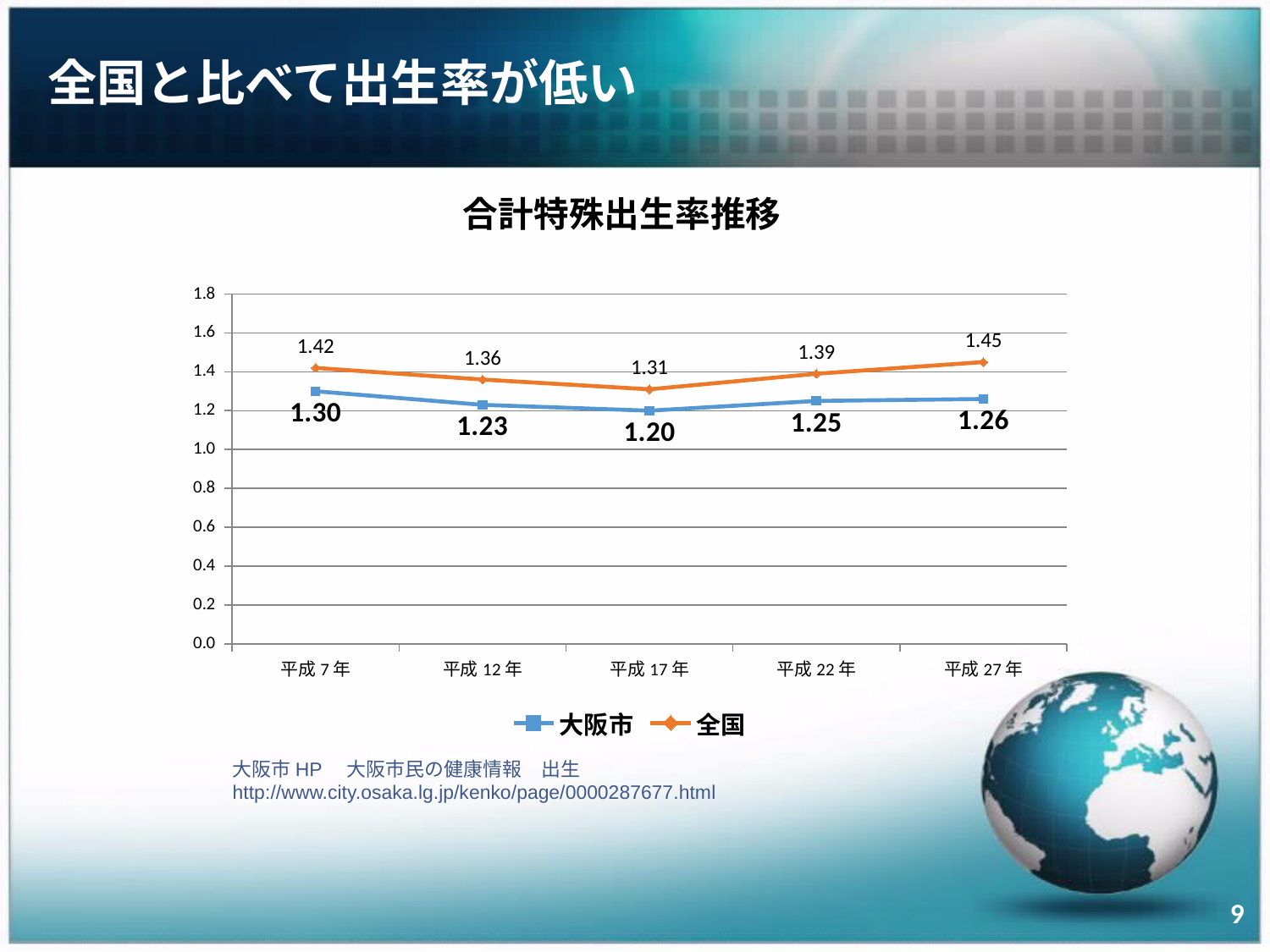
What is the value for 全国 in 平成27年? 1.45 Which is larger in 平成22年, the 大阪市 value or the 全国 value? 全国 What is the value for 全国 in 平成7年? 1.42 How many series does the legend list? 2 What is the value for 大阪市 in 平成17年? 1.20 What is the title of the chart? 合計特殊出生率推移 What is the difference between the 全国 and 大阪市 values in 平成27年? 0.19 What kind of chart is shown? line chart In which year is the 大阪市 value highest? 平成7年 In which year is the 全国 value lowest? 平成17年 What is the difference between the 全国 and 大阪市 values in 平成7年? 0.12 How many years are shown on the x axis? 5